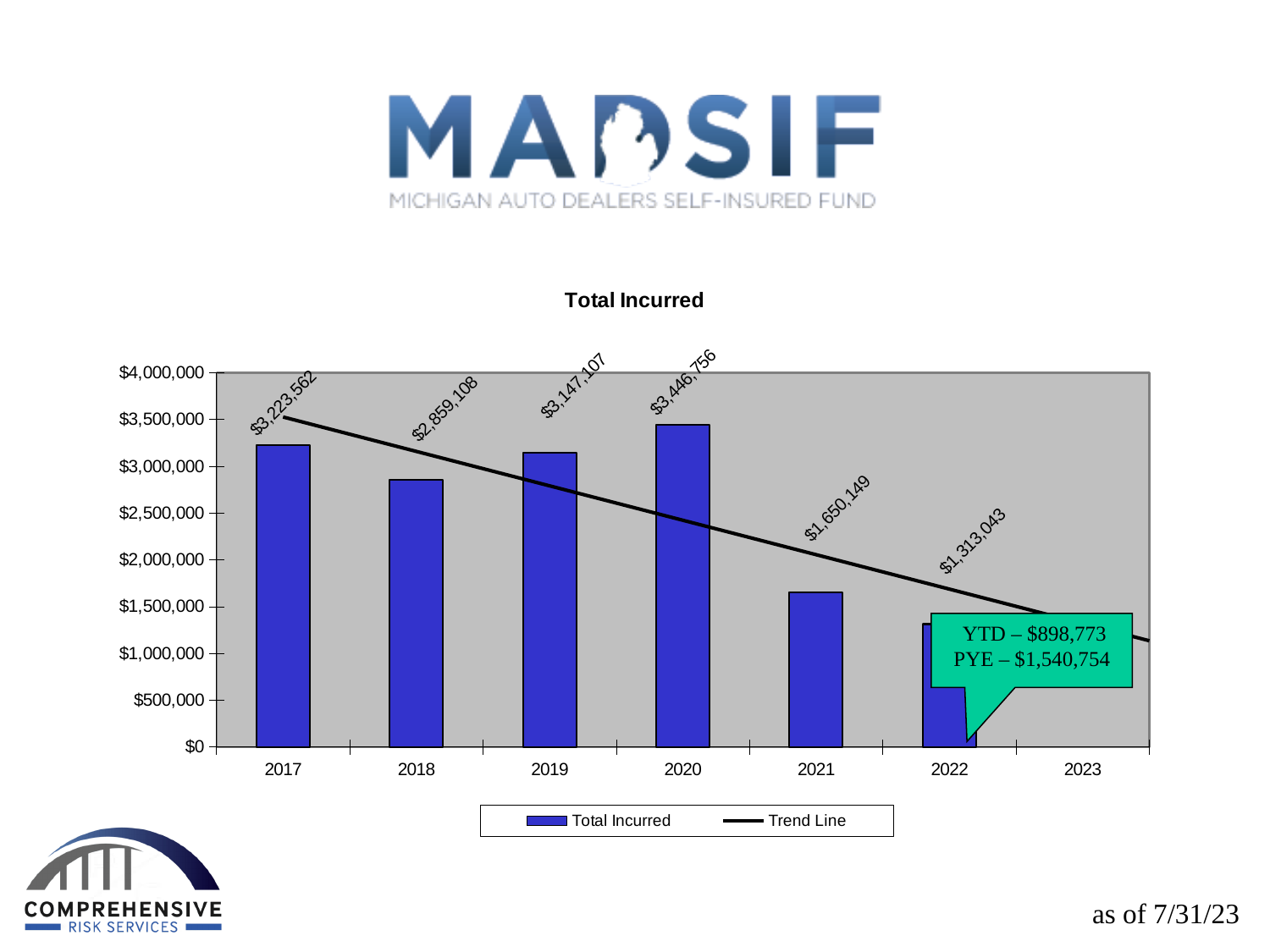
Is the Total Incurred value for 2021 greater or less than $2,000,000? less Which year has a larger Total Incurred value, 2017 or 2019? 2017 What is the Total Incurred value for 2020? $3,446,756 How many years are shown on the x axis of the chart? 7 Which year has the highest Total Incurred value among the labeled bars? 2020 What is the Total Incurred value for 2022? $1,313,043 Which year has the lowest labeled Total Incurred value? 2022 What is the Total Incurred value for 2021? $1,650,149 How many series does the legend list? 2 What kind of chart is used to show the Total Incurred values? bar chart What is the difference between the Total Incurred values for 2020 and 2021? $1,796,607 What is the Total Incurred value for 2018? $2,859,108